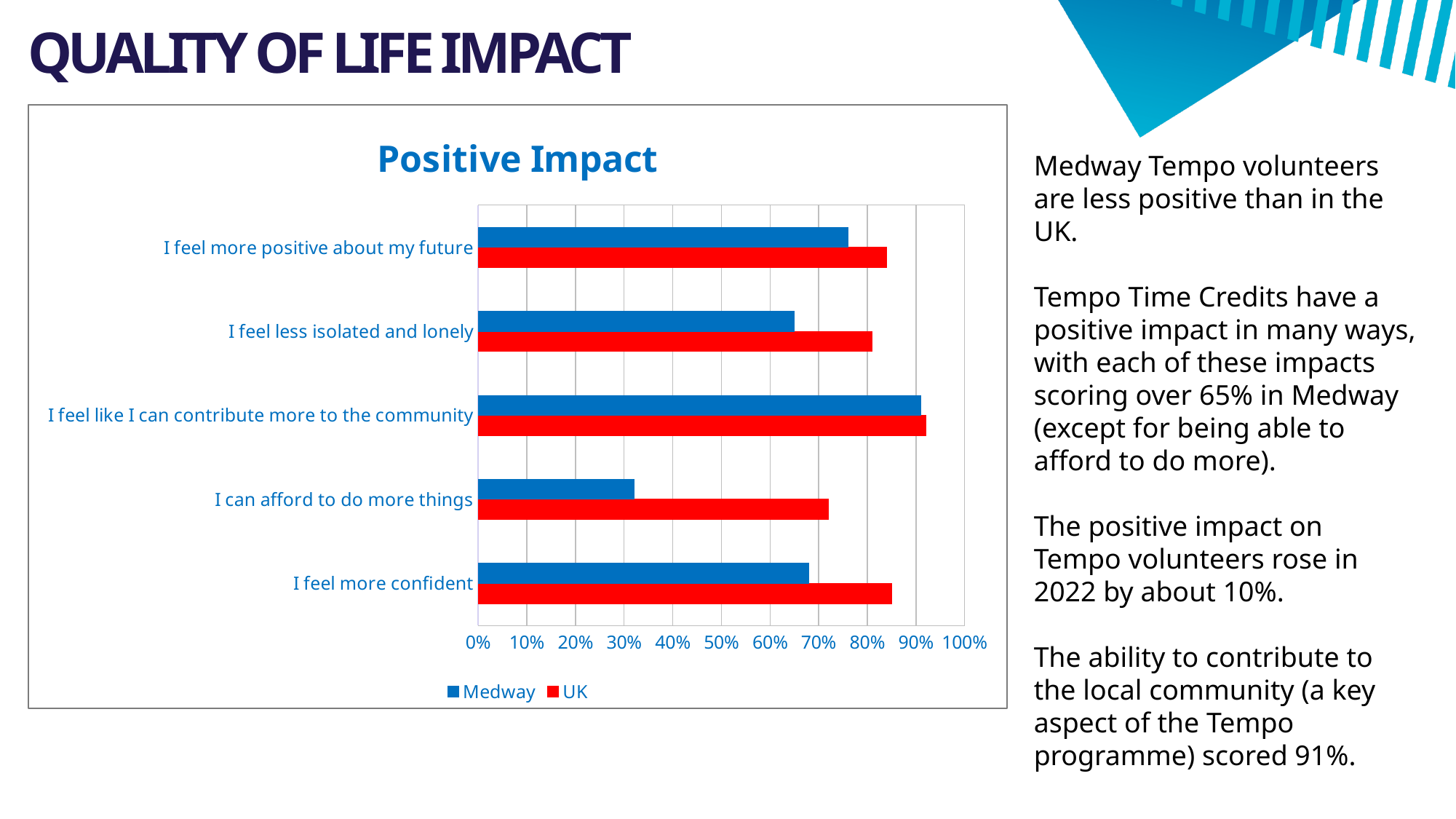
What kind of chart is shown on the slide? bar chart Is the UK value for 'I feel more confident' greater or less than 80%? greater Is the Medway value for 'I can afford to do more things' greater or less than 40%? less Which category has the highest Medway value? I feel like I can contribute more to the community What is the title of the chart? Positive Impact How many series does the legend list? 2 For 'I feel more positive about my future', which is larger, the Medway value or the UK value? UK For 'I can afford to do more things', which is larger, the Medway value or the UK value? UK How many categories are shown on the chart? 5 Which category has the lowest UK value? I can afford to do more things Which category has the lowest Medway value? I can afford to do more things Is the Medway value for 'I feel like I can contribute more to the community' greater or less than 80%? greater